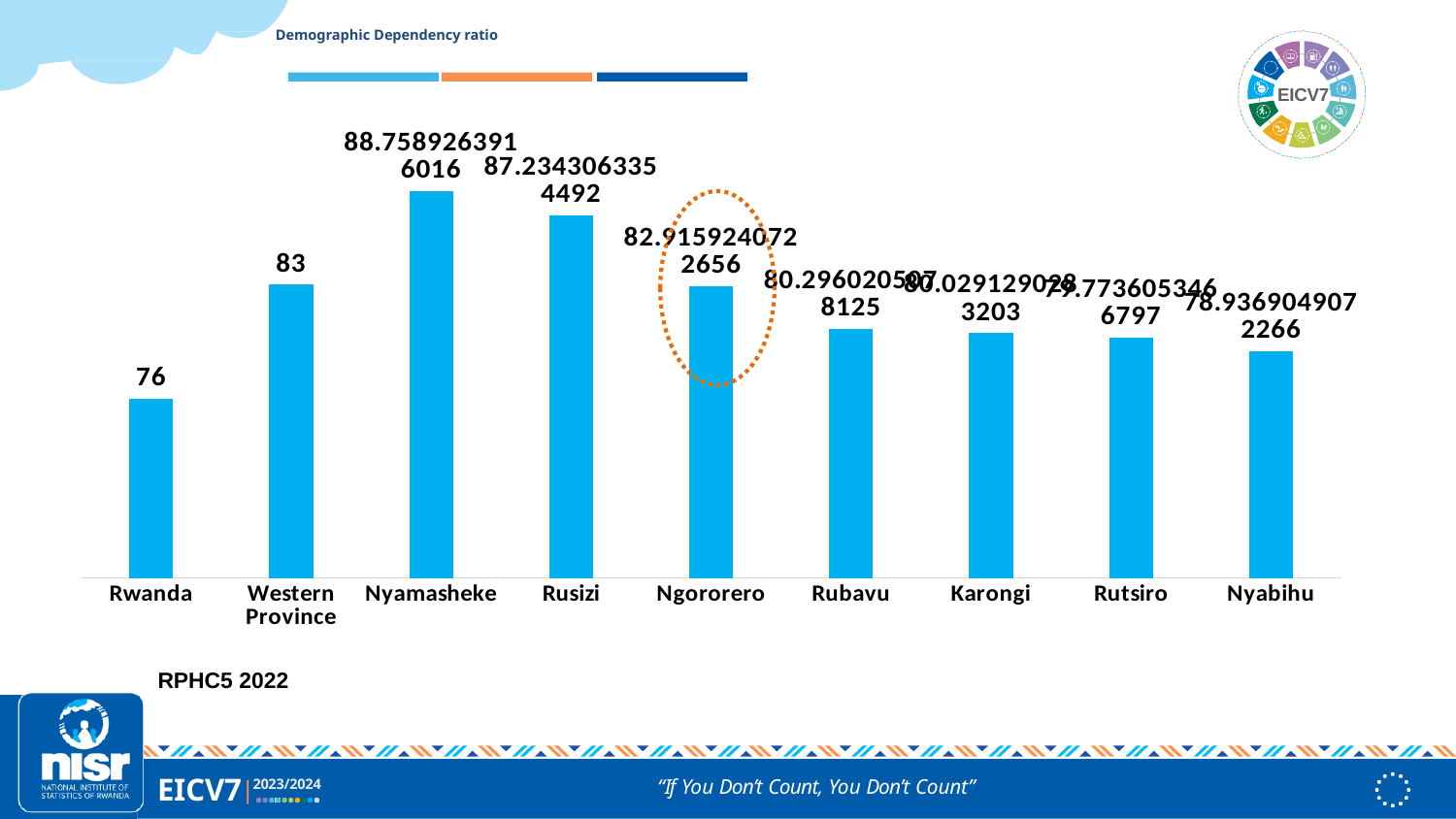
Which category has the lowest value? Rwanda What is the value for Rwanda? 76 What kind of chart is shown on the slide? Bar chart What is the value for Western Province? 83 Which bar is highlighted with a dotted orange circle? Ngororero How many categories are shown on the x axis? 9 What is the value shown for Nyamasheke? 88.7589263916016 Which is larger, the value for Nyamasheke or the value for Rusizi? Nyamasheke What is the value shown for Rusizi? 87.2343063354492 Which is larger, the value for Ngororero or the value for Nyabihu? Ngororero Which category has the highest value? Nyamasheke What is the difference between the values for Western Province and Rwanda? 7